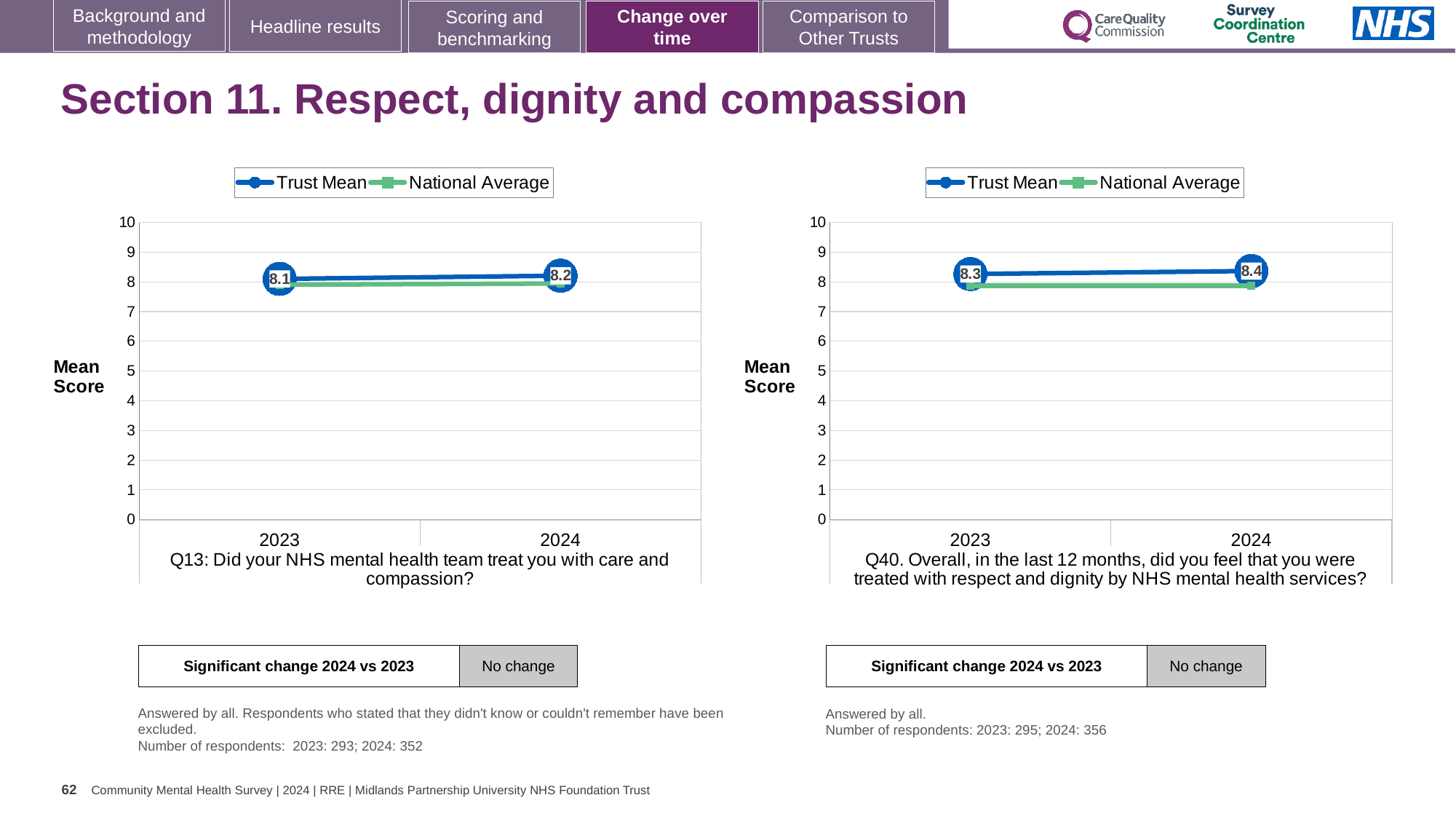
In the Q13 chart on the left, by how much did the Trust Mean change from 2023 to 2024? 0.1 In the Q40 chart on the right, what is the Trust Mean for 2024? 8.4 In the Q13 chart on the left, is the National Average for 2023 greater or less than 7? greater In the Q40 chart on the right, is the National Average for 2024 greater or less than 9? less How many series does the legend of the Q13 chart on the left list? 2 In the Q40 chart on the right, what is the Trust Mean for 2023? 8.3 What is the label on the y axis of the Q40 chart on the right? Mean Score In the Q13 chart on the left, what is the Trust Mean for 2024? 8.2 What kind of chart is the Q13 chart on the left? line chart In the Q40 chart on the right, does the Trust Mean rise or fall from 2023 to 2024? rise In the Q13 chart on the left, what is the Trust Mean for 2023? 8.1 How many years are plotted on the x axis of the Q40 chart on the right? 2